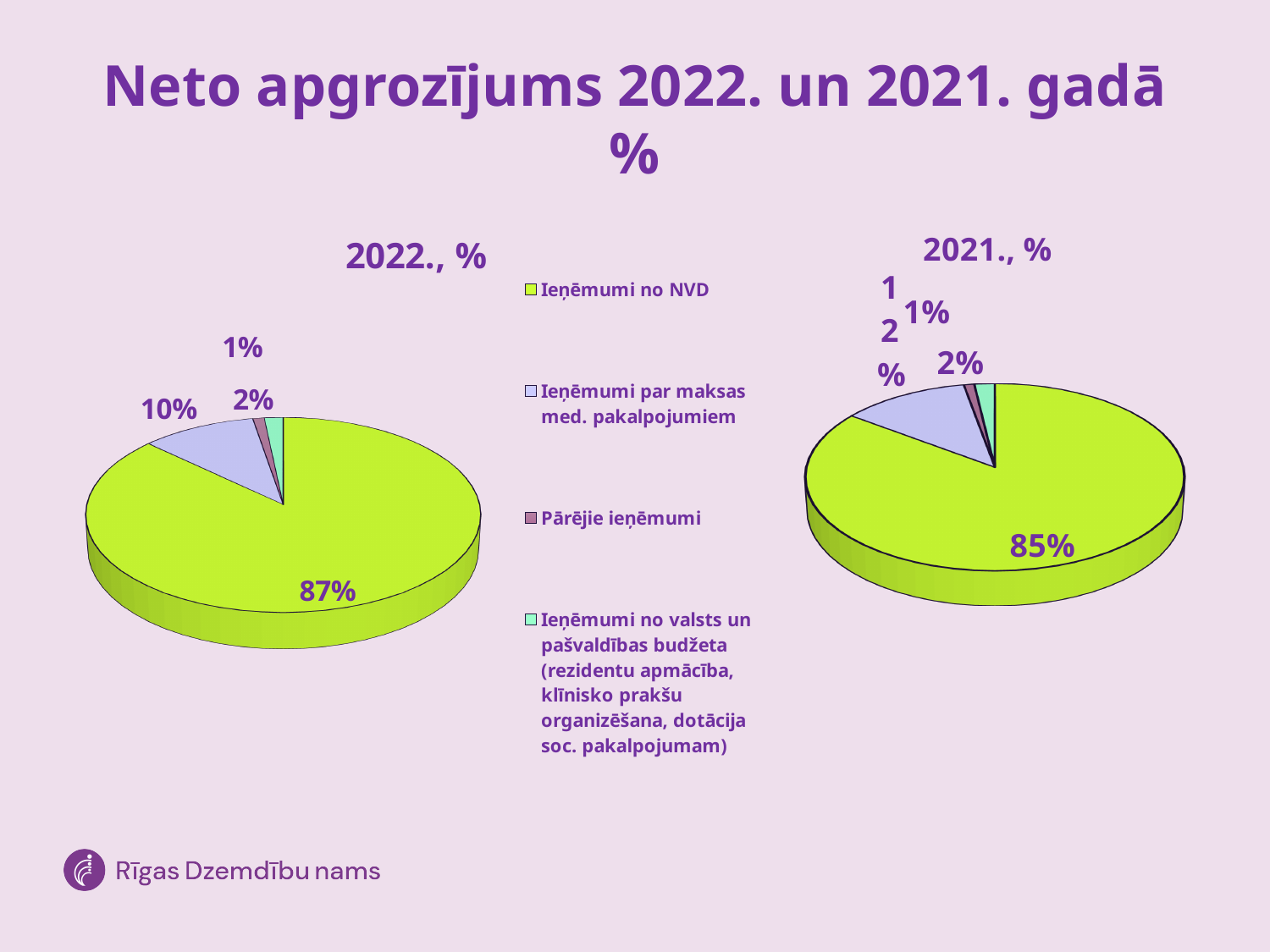
In the 2021., % pie chart, which category has the largest slice? Ieņēmumi no NVD In the 2021., % pie chart, what share is shown for Ieņēmumi no NVD? 85% By how many percentage points does the Ieņēmumi par maksas med. pakalpojumiem share in the 2021., % chart exceed that in the 2022., % chart? 2 percentage points In the 2022., % pie chart, what share is shown for Ieņēmumi no NVD? 87% Is the share of Ieņēmumi no NVD larger in the 2022., % chart or the 2021., % chart? 2022., % In the 2022., % pie chart, what share is shown for Ieņēmumi par maksas med. pakalpojumiem? 10% In the 2021., % pie chart, what share is shown for Ieņēmumi par maksas med. pakalpojumiem? 12% In the 2022., % pie chart, which category has the largest slice? Ieņēmumi no NVD What colour represents Ieņēmumi no NVD in the pie charts? Green What type of chart is used for the 2022., % and 2021., % data on this slide? Pie chart By how many percentage points does the Ieņēmumi no NVD share in the 2022., % chart exceed that in the 2021., % chart? 2 percentage points How many categories does the legend list for the pie charts? 4